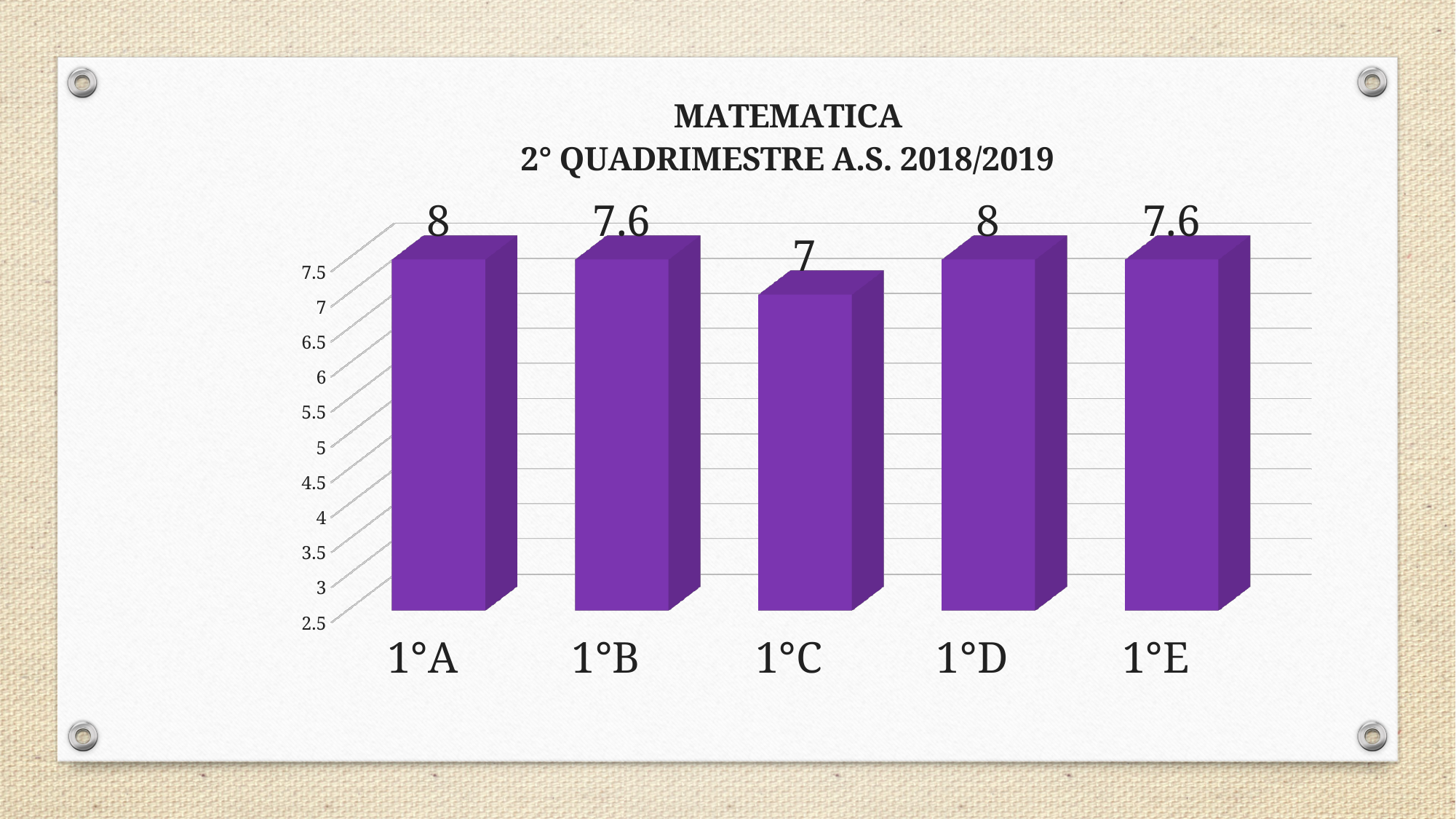
Is the value for 1°C greater or less than 6? greater What is the value for 1°E? 7.6 What is the value for 1°A? 8 What is the value for 1°B? 7.6 What kind of chart is shown on the slide? bar chart Which is larger, the value for 1°D or the value for 1°E? 1°D What is the difference between the values for 1°B and 1°C? 0.6 How many classes are shown on the x axis? 5 What is the difference between the values for 1°A and 1°C? 1 What is the value for 1°D? 8 What is the value for 1°C? 7 Which class has the lowest value? 1°C